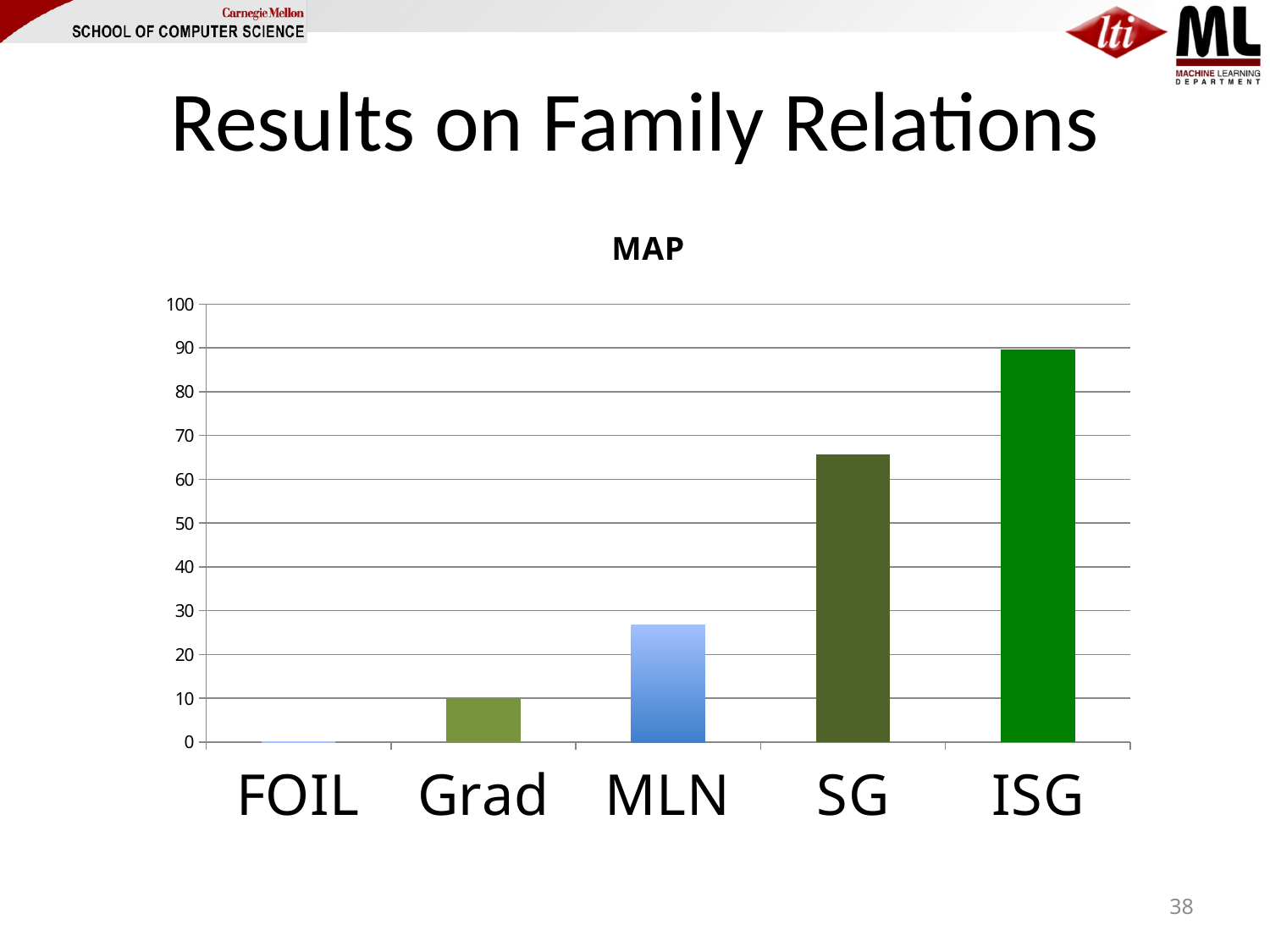
Is the value for MLN greater or less than 20? greater Which category has the lowest value in the chart? FOIL What is the title of the chart? MAP How many categories are shown on the x axis of the chart? 5 Is the value for SG greater or less than 70? less Which has the larger value, Grad or ISG? ISG Which category has the highest value in the chart? ISG What kind of chart is shown on the slide? bar chart Which has the larger value, SG or MLN? SG Is the value for ISG greater or less than 80? greater Do the values generally rise or fall moving from FOIL to ISG along the x axis? rise